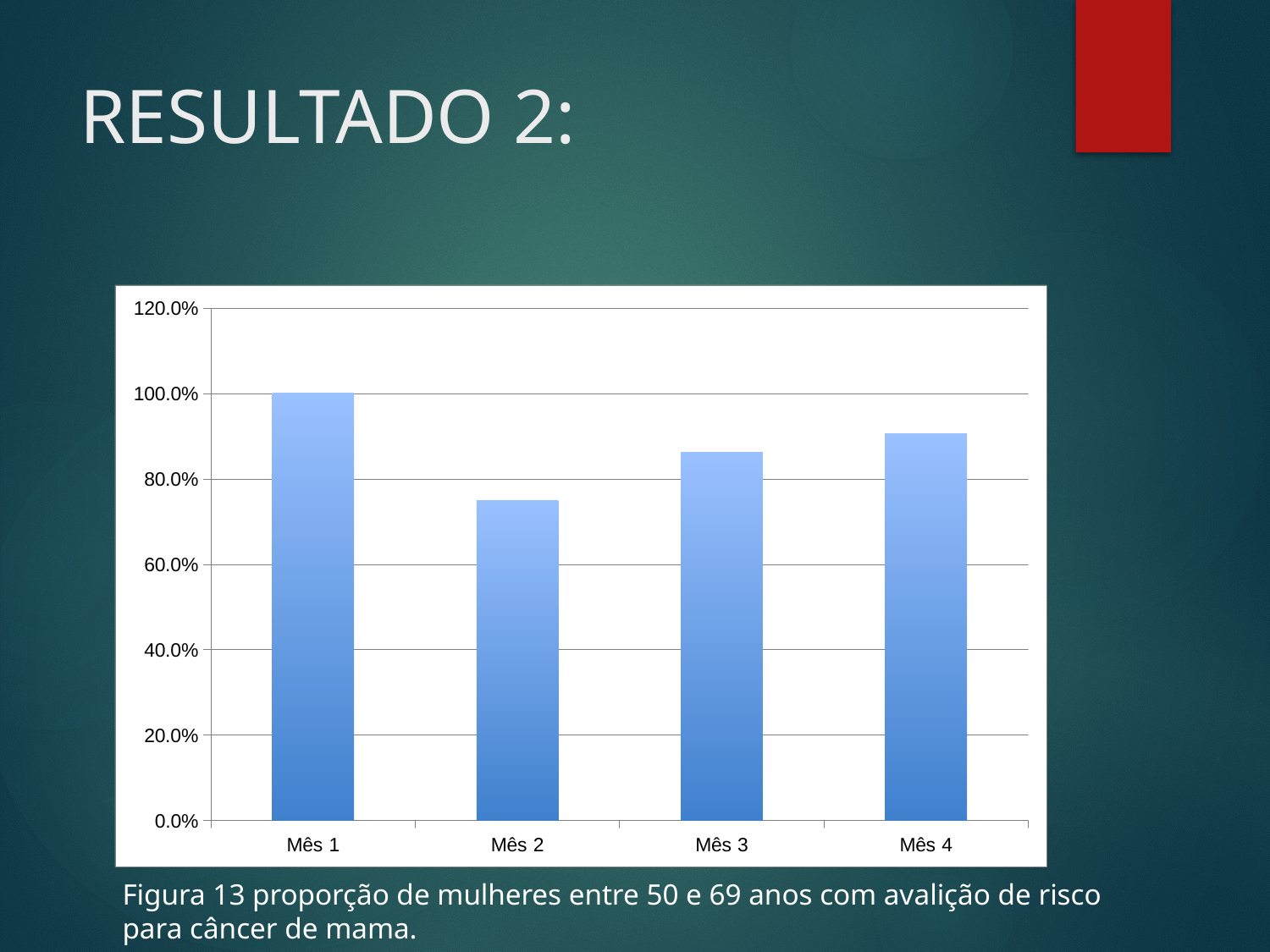
Which month has the highest bar? Mês 1 Is the value for Mês 3 greater or less than 80.0%? greater Which month has the lowest bar? Mês 2 Is the value for Mês 4 greater or less than 100.0%? less What kind of chart is shown on the slide? bar chart What is the value for Mês 1? 100.0% How many categories (months) are plotted on the x axis? 4 Is the value for Mês 2 greater or less than 80.0%? less Which is larger, the value for Mês 3 or the value for Mês 4? Mês 4 What is the highest tick value shown on the y axis? 120.0% Do the values rise or fall from Mês 2 to Mês 4? rise Which is larger, the value for Mês 2 or the value for Mês 3? Mês 3